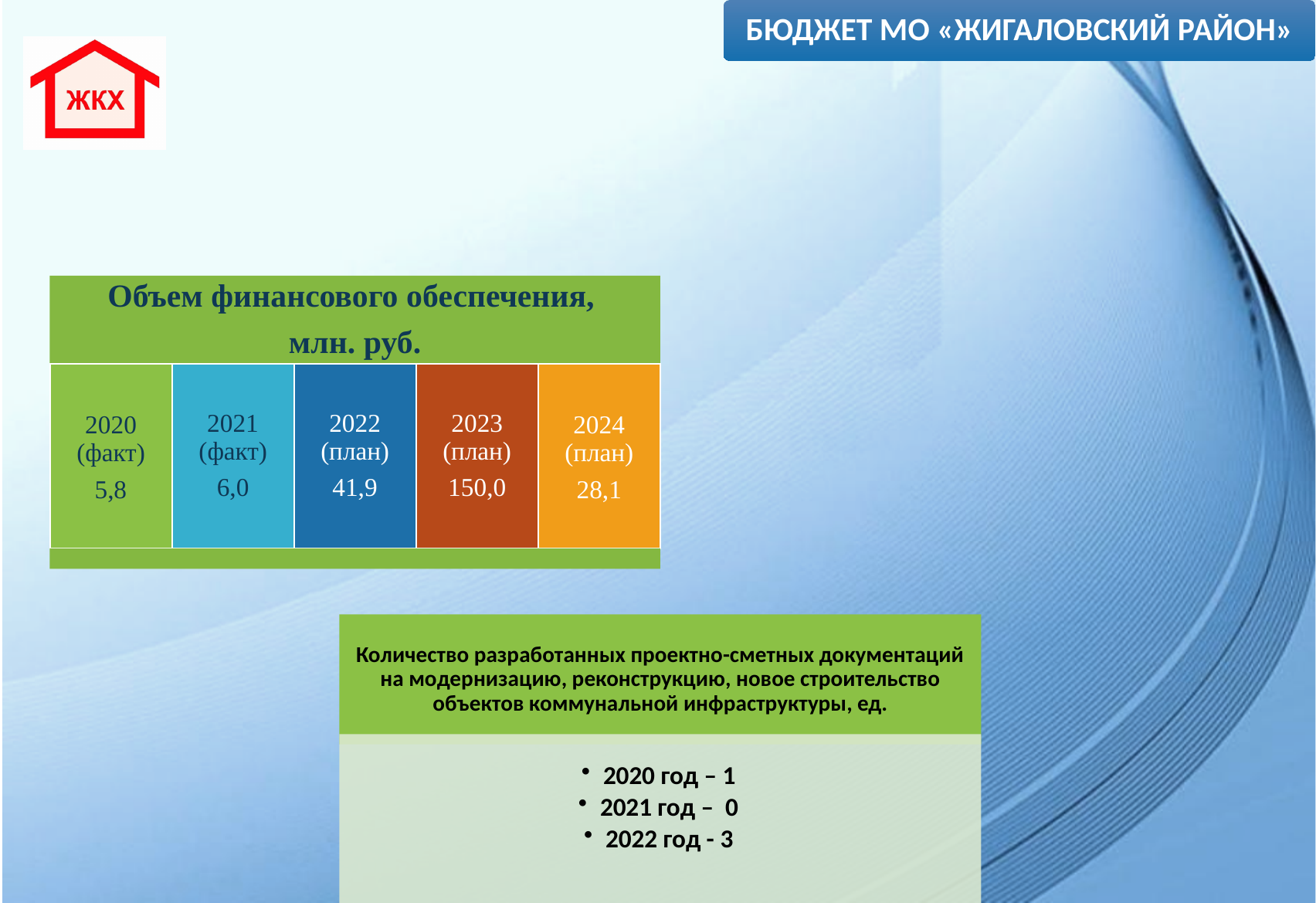
In the "Объем финансового обеспечения, млн. руб." block, which is larger: the value for 2022 (план) or 2024 (план)? 2022 (план) In the "Объем финансового обеспечения, млн. руб." block, which year has the highest value? 2023 (план) In the "Объем финансового обеспечения, млн. руб." block, what is the value for 2022 (план)? 41,9 In the "Объем финансового обеспечения, млн. руб." block, which year has the lowest value? 2020 (факт) In the "Объем финансового обеспечения, млн. руб." block, what is the value for 2023 (план)? 150,0 In the "Объем финансового обеспечения, млн. руб." block, what is the value for 2024 (план)? 28,1 In the "Объем финансового обеспечения, млн. руб." block, what is the value for 2021 (факт)? 6,0 In the "Объем финансового обеспечения, млн. руб." block, what is the difference between the 2021 (факт) and 2020 (факт) values? 0,2 In the "Объем финансового обеспечения, млн. руб." block, what colour is the 2023 (план) block? Brown (dark orange) In the "Объем финансового обеспечения, млн. руб." block, what is the difference between the 2023 (план) and 2024 (план) values? 121,9 How many years are shown in the "Объем финансового обеспечения, млн. руб." block? 5 In the "Объем финансового обеспечения, млн. руб." block, what is the value for 2020 (факт)? 5,8